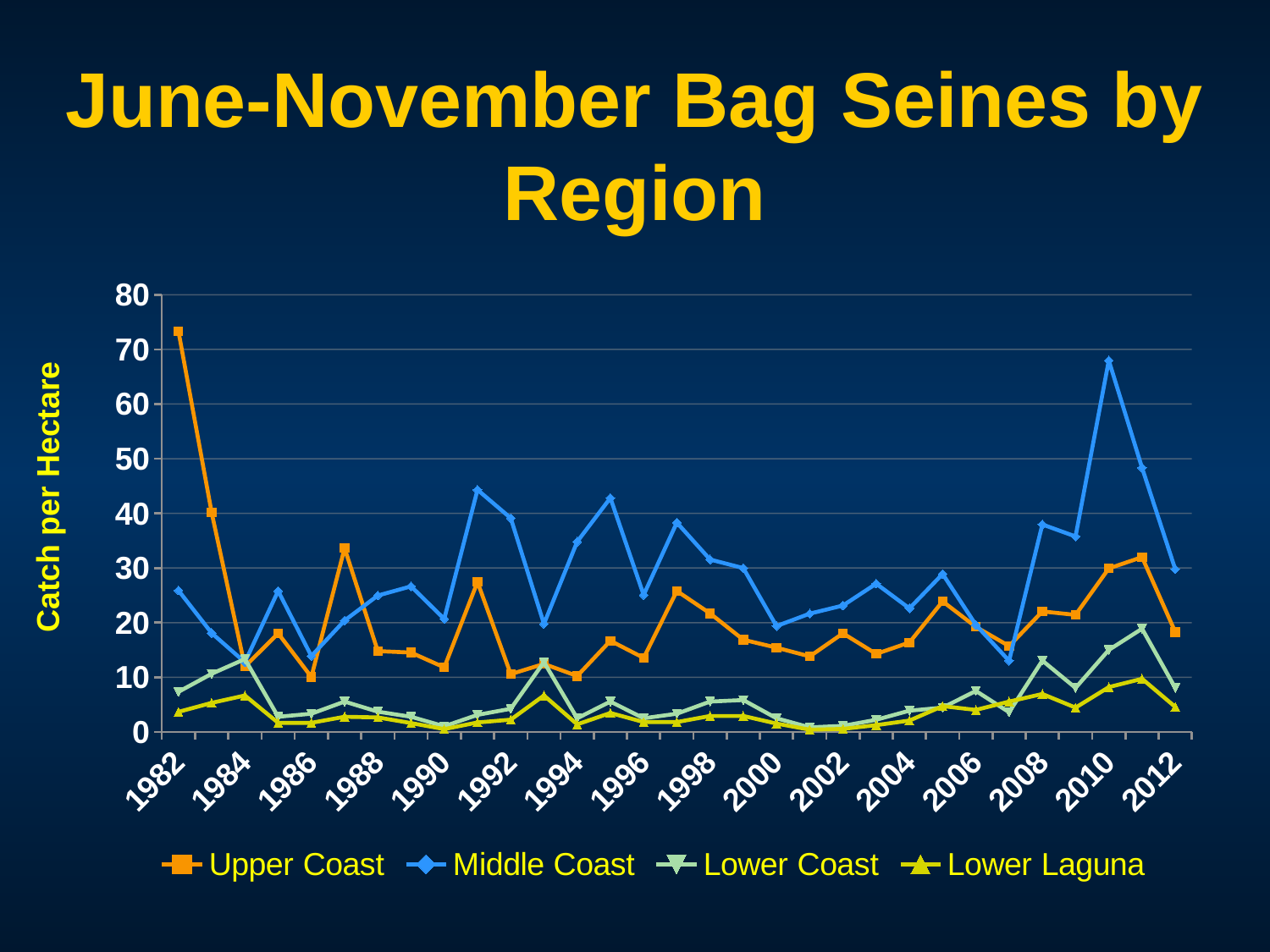
Is the value for Middle Coast in 2010 greater or less than 60? greater How many series does the legend list? 4 What are the four series named in the legend? Upper Coast, Middle Coast, Lower Coast, Lower Laguna What kind of chart is shown on the slide? line chart In which year does the Upper Coast series reach its highest value? 1982 Is the value for Middle Coast in 2012 greater or less than 20? greater In 1982, which is larger: Upper Coast or Middle Coast? Upper Coast Does the Upper Coast series rise or fall from 1982 to 1984? fall In 2010, which is larger: Middle Coast or Upper Coast? Middle Coast What is the title of the vertical axis? Catch per Hectare In which year does the Middle Coast series reach its highest value? 2010 Is the value for Upper Coast in 1982 greater or less than 70? greater